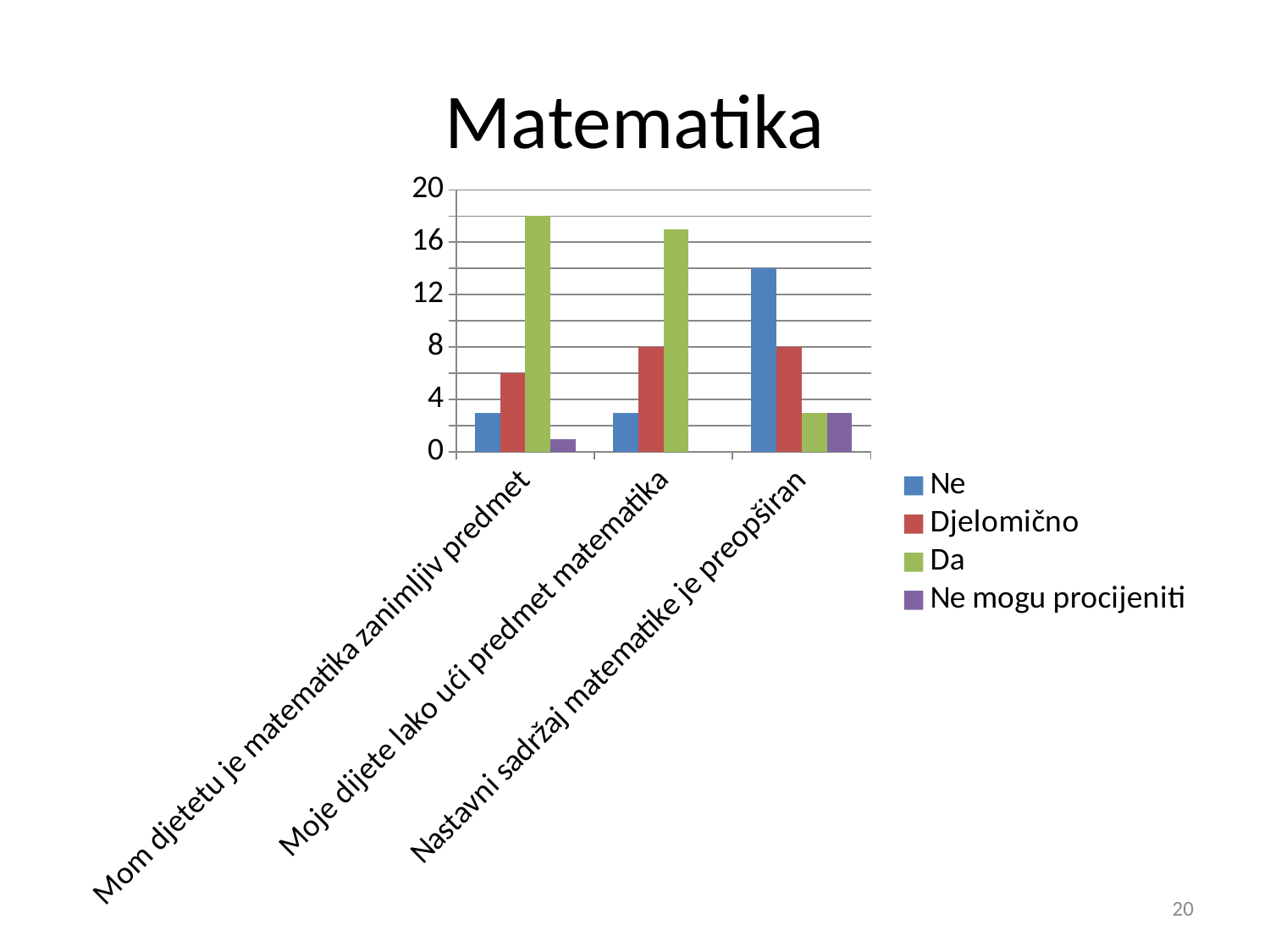
Which series has the highest value for "Mom djetetu je matematika zanimljiv predmet"? Da What is the value of "Djelomično" for "Nastavni sadržaj matematike je preopširan"? 8 What is the title of the chart? Matematika Is the value of "Da" for "Mom djetetu je matematika zanimljiv predmet" greater or less than 16? greater What is the value of "Djelomično" for "Moje dijete lako uči predmet matematika"? 8 How many categories are shown on the x axis? 3 How many series does the legend list? 4 What kind of chart is shown on the slide? bar chart Is the value of "Ne" for "Nastavni sadržaj matematike je preopširan" greater or less than 12? greater Which series has the lowest value for "Mom djetetu je matematika zanimljiv predmet"? Ne mogu procijeniti Which is larger: "Da" for "Moje dijete lako uči predmet matematika" or "Da" for "Nastavni sadržaj matematike je preopširan"? Da for Moje dijete lako uči predmet matematika Which series has the highest value for "Nastavni sadržaj matematike je preopširan"? Ne